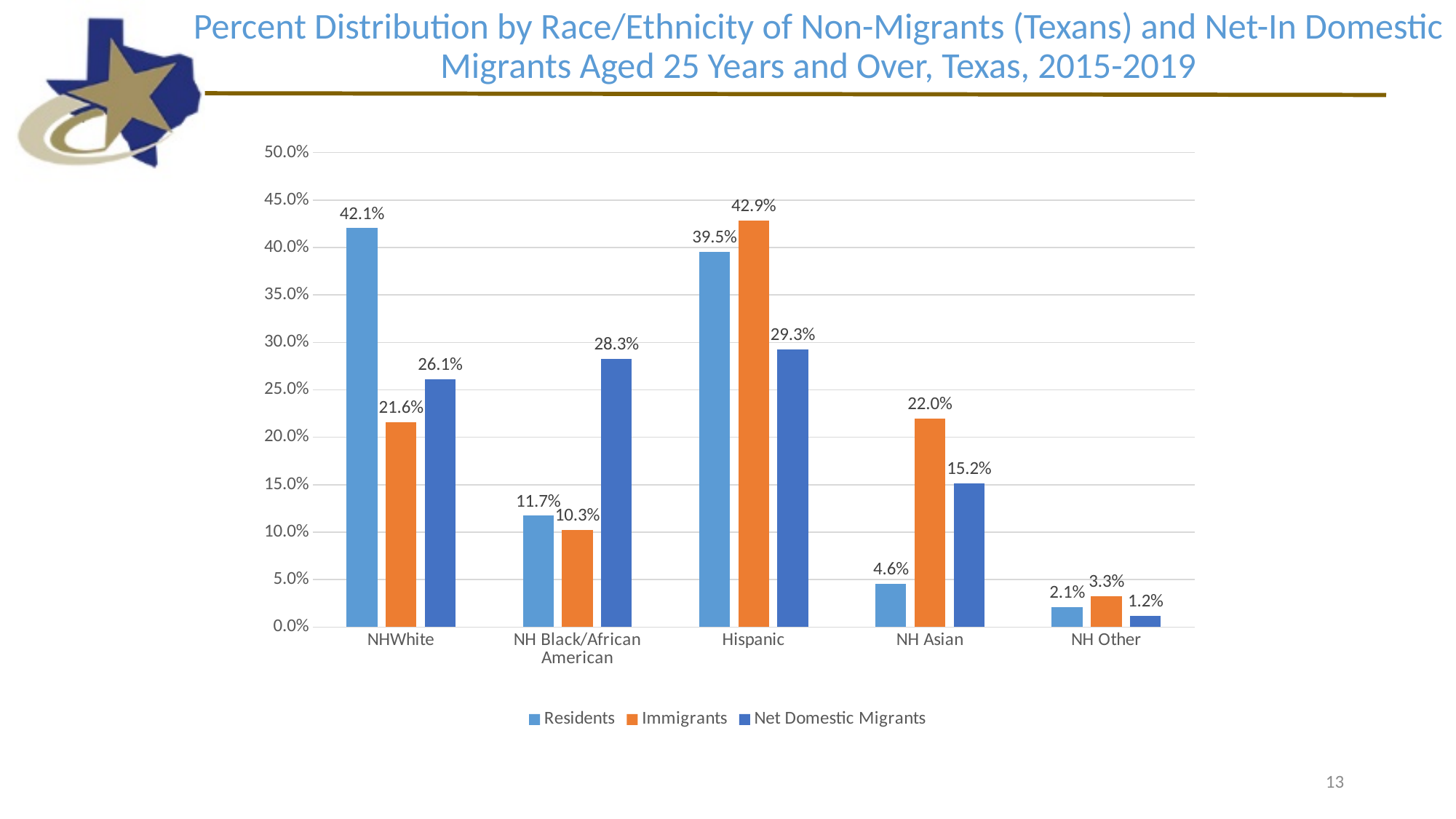
Which is larger in the NH Black/African American category: Residents or Net Domestic Migrants? Net Domestic Migrants Which category has the highest value for Immigrants? Hispanic How many series does the legend list? 3 Is the value for Net Domestic Migrants in the Hispanic category greater or less than 25.0%? greater How many race/ethnicity categories are shown on the x axis? 5 What kind of chart is shown on the slide? bar chart What is the value for Net Domestic Migrants in the NH Asian category? 15.2% Which series is shown in orange in the legend? Immigrants What is the difference between the Residents and Immigrants values in the NHWhite category? 20.5% What is the value for Residents in the NHWhite category? 42.1% Which category has the lowest value for Net Domestic Migrants? NH Other What is the value for Immigrants in the Hispanic category? 42.9%